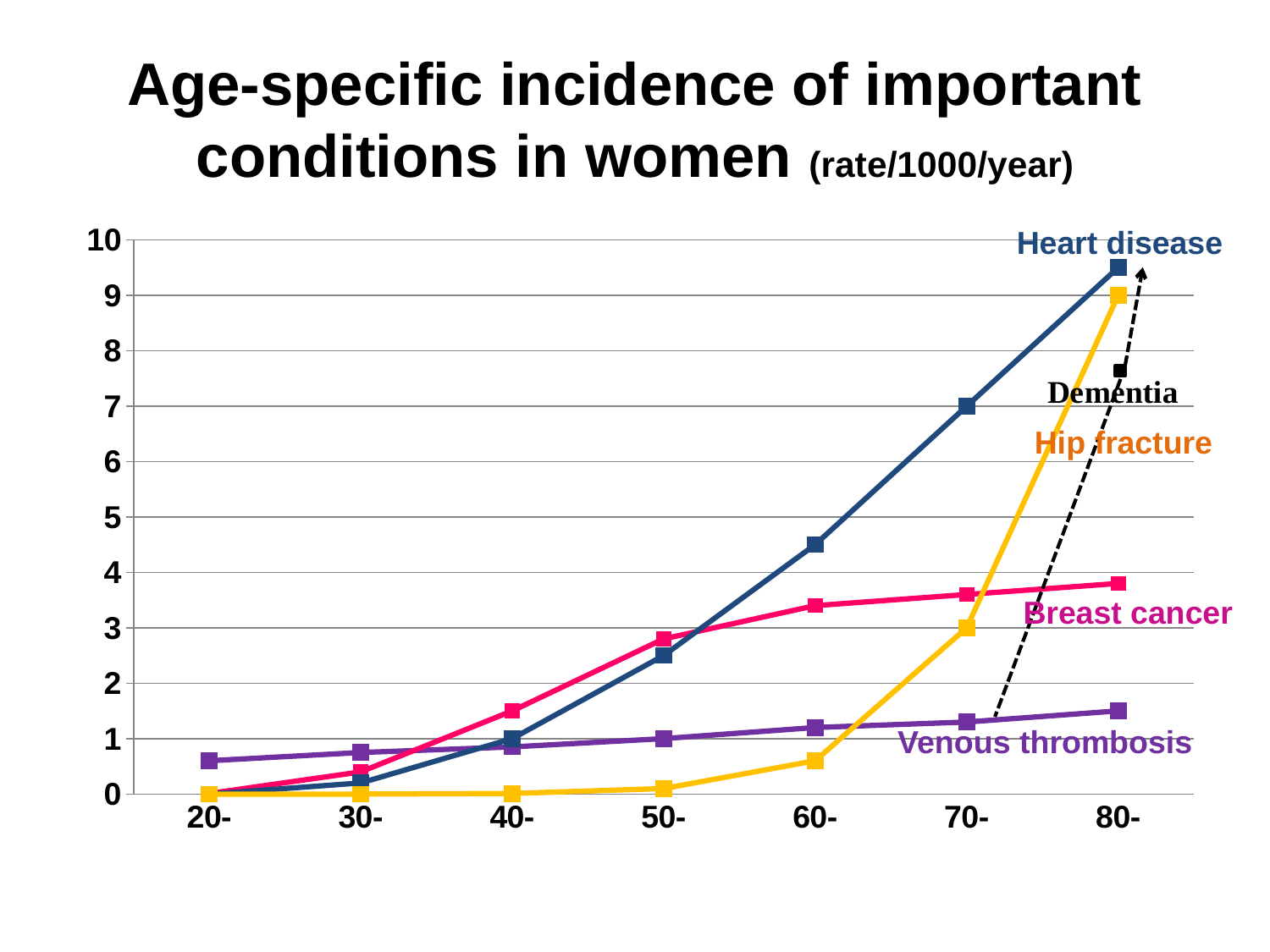
Is the hip fracture rate for the 60- age group greater or less than 1? less Does the heart disease rate rise or fall as age increases from 20- to 80-? Rises Is the heart disease rate for the 60- age group greater or less than 4? greater What kind of chart is shown on the slide? Line chart How many age groups are shown on the x axis? 7 What is the venous thrombosis rate for the 50- age group? 1 What is the hip fracture rate for the 70- age group? 3 In the 60- age group, which is higher: heart disease or breast cancer? Heart disease Which condition has the lowest rate in the 80- age group? Venous thrombosis What is the heart disease rate for the 70- age group? 7 Which condition has the highest rate in the 80- age group? Heart disease What is the hip fracture rate for the 80- age group? 9